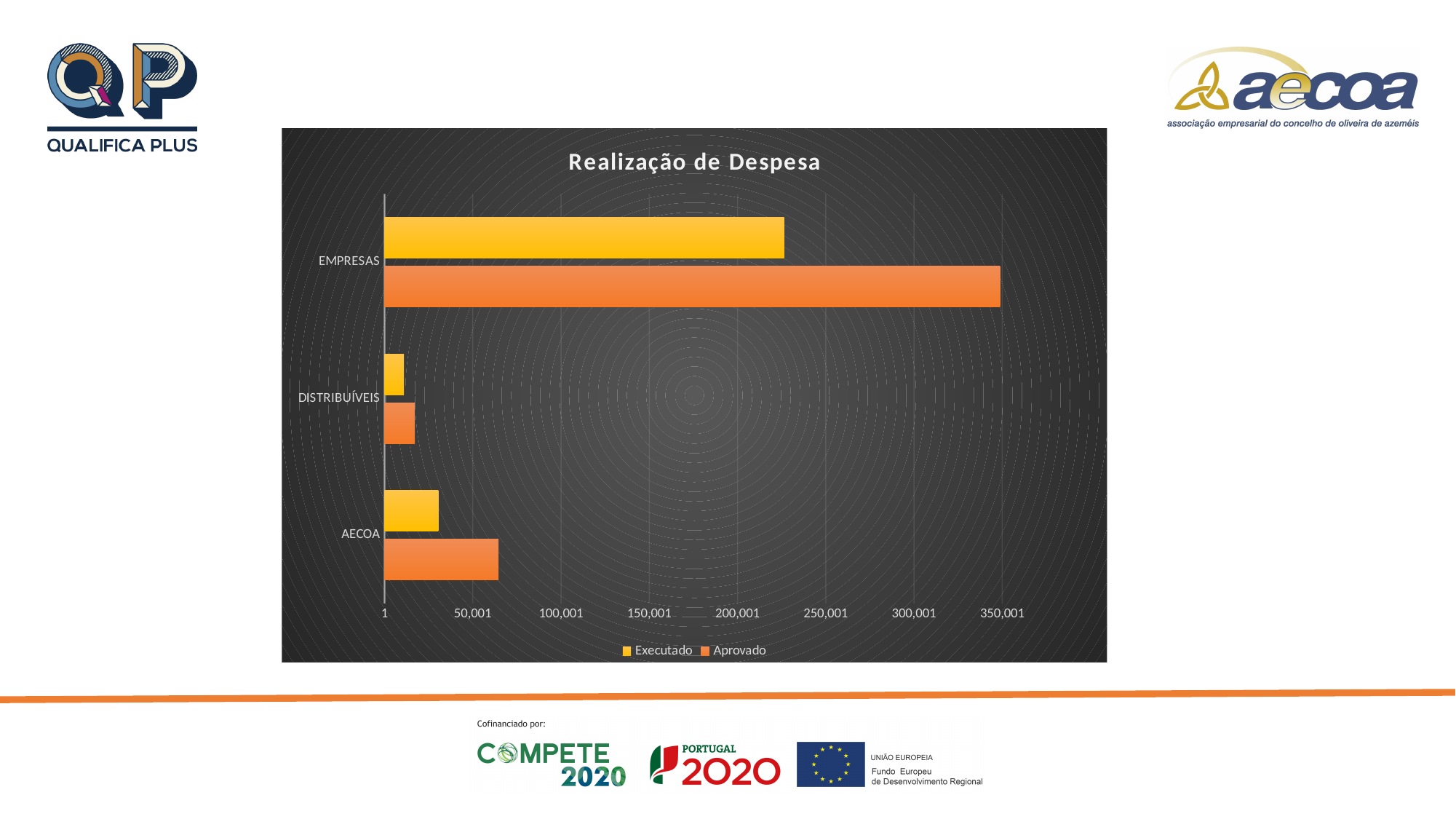
Which category has the lowest Executado value? DISTRIBUÍVEIS Is the Executado value for AECOA greater or less than 50,001? less What type of chart is shown on the slide? bar chart Is the Executado value for EMPRESAS greater or less than 200,001? greater Which category has the highest Aprovado value? EMPRESAS What is the title of the chart? Realização de Despesa How many series does the legend list? 2 For EMPRESAS, which is larger: Executado or Aprovado? Aprovado For AECOA, which is larger: Executado or Aprovado? Aprovado Is the Aprovado value for EMPRESAS greater or less than 300,001? greater How many categories are shown on the chart? 3